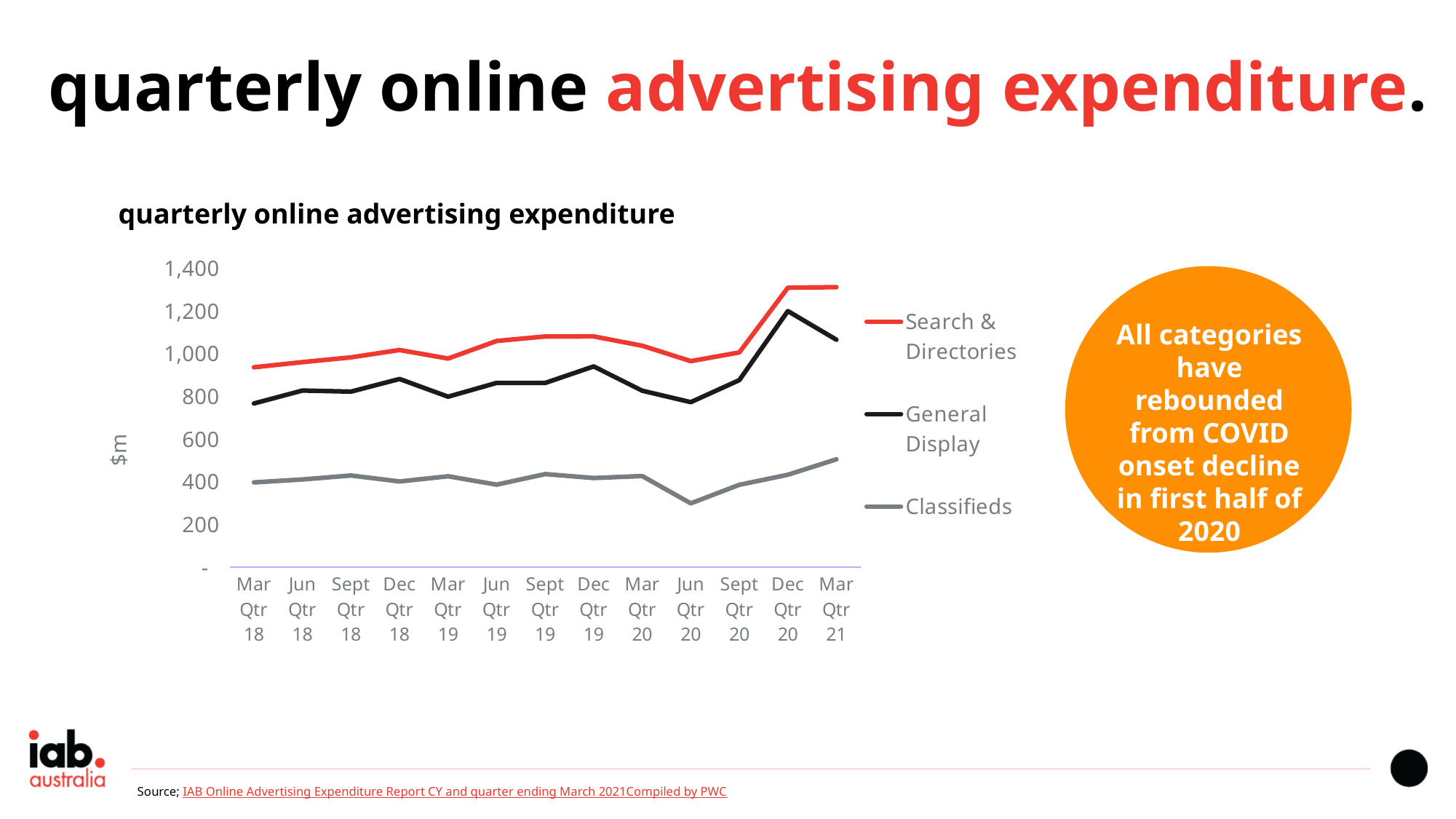
Which is larger for General Display: the value in Dec Qtr 20 or the value in Mar Qtr 21? Dec Qtr 20 Is the value for Classifieds in Jun Qtr 20 greater or less than 400? less What unit is shown on the y axis? $m How many quarters are plotted along the x axis? 13 In which quarter does Classifieds reach its lowest value? Jun Qtr 20 Which series has the highest value in Mar Qtr 21? Search & Directories Is the value for General Display in Dec Qtr 20 greater or less than 1,000? greater How many series does the legend list? 3 Is the value for Search & Directories in Mar Qtr 21 greater or less than 1,200? greater Which series has the lowest values across all quarters? Classifieds In which quarter does General Display reach its highest value? Dec Qtr 20 What type of chart is shown on the slide? Line chart